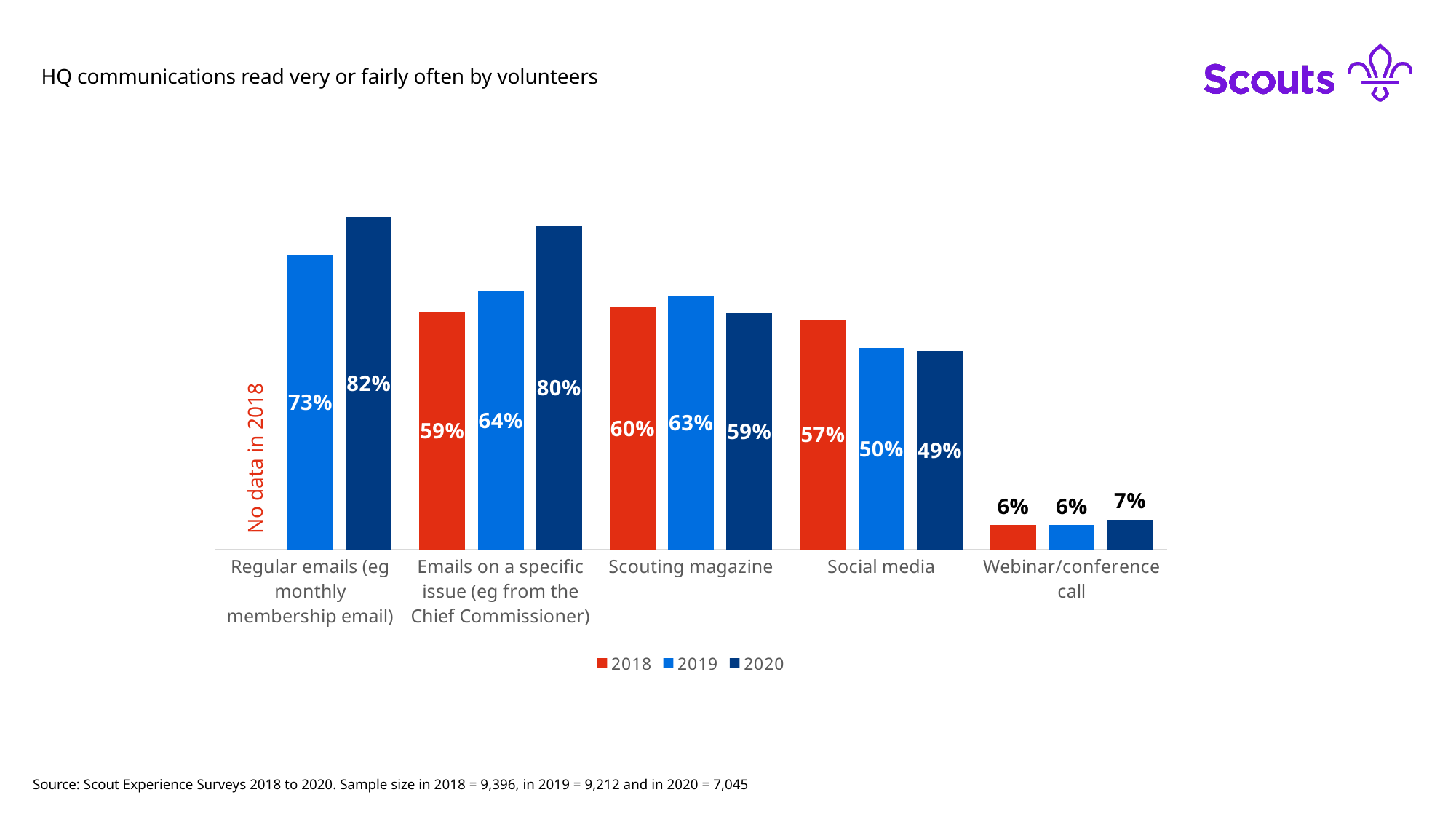
What kind of chart is shown on the slide? Bar chart Do the values for Social media rise or fall from 2018 to 2020? Fall Which is larger for Scouting magazine: the 2019 value or the 2020 value? 2019 What is the 2018 value for Scouting magazine? 60% How many categories are shown on the x axis? 5 What is the difference between the 2019 and 2020 values for Emails on a specific issue (eg from the Chief Commissioner)? 16% How many series does the legend list? 3 Which category has no data for 2018? Regular emails (eg monthly membership email) What is the 2020 value for Regular emails (eg monthly membership email)? 82% Which category has the highest 2020 value? Regular emails (eg monthly membership email) What is the 2019 value for Social media? 50% Which category has the lowest 2019 value? Webinar/conference call